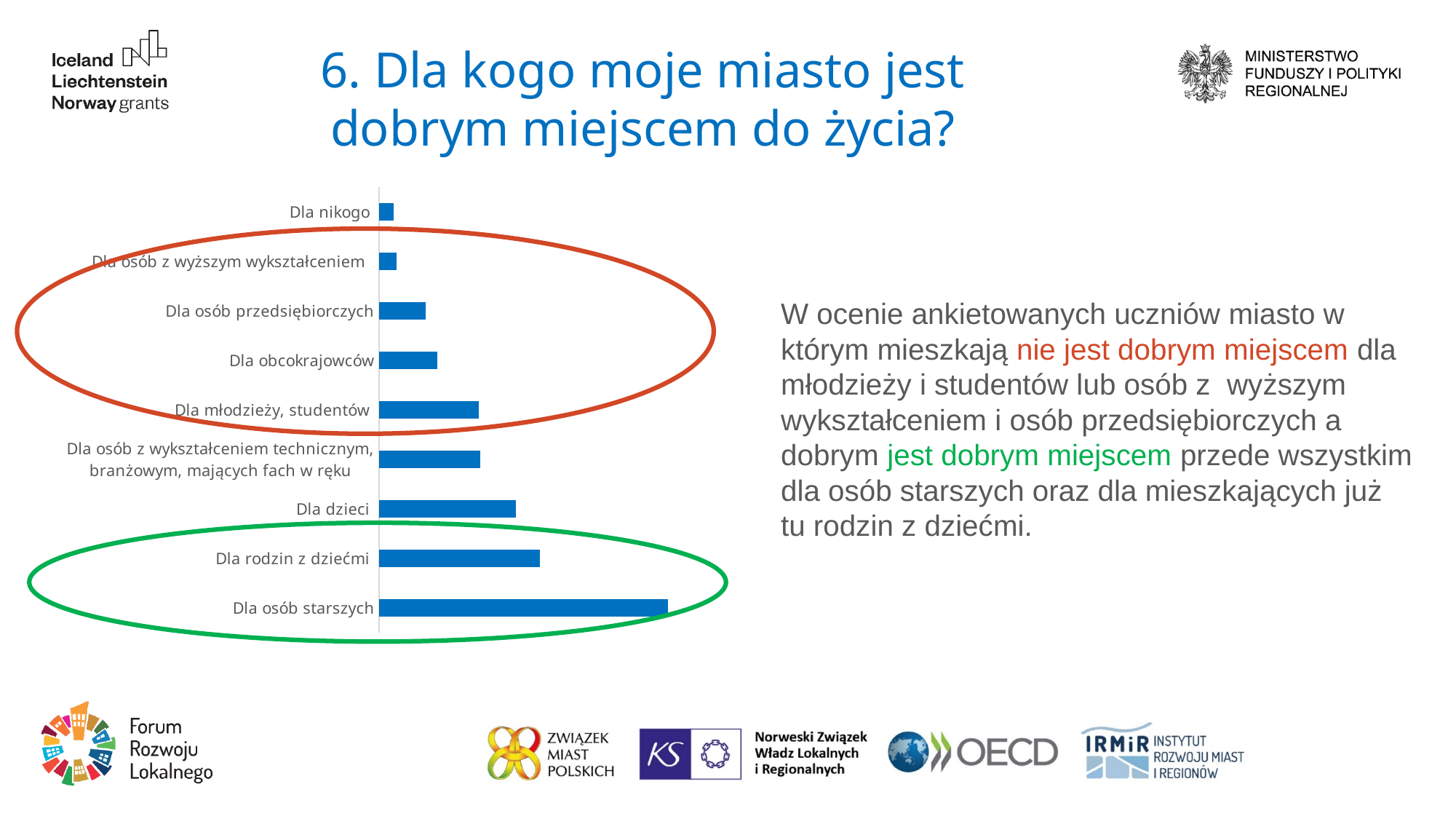
What colour are the bars in the chart? Blue Which category has the longest bar in the chart? Dla osób starszych Which two categories are enclosed by the green ellipse on the chart? Dla rodzin z dziećmi and Dla osób starszych How many categories does the bar chart show? 9 Which bar is longer: "Dla obcokrajowców" or "Dla osób z wyższym wykształceniem"? Dla obcokrajowców What kind of chart is shown on the slide? Bar chart Which bar is longer: "Dla osób starszych" or "Dla rodzin z dziećmi"? Dla osób starszych Which bar is longer: "Dla dzieci" or "Dla osób przedsiębiorczych"? Dla dzieci